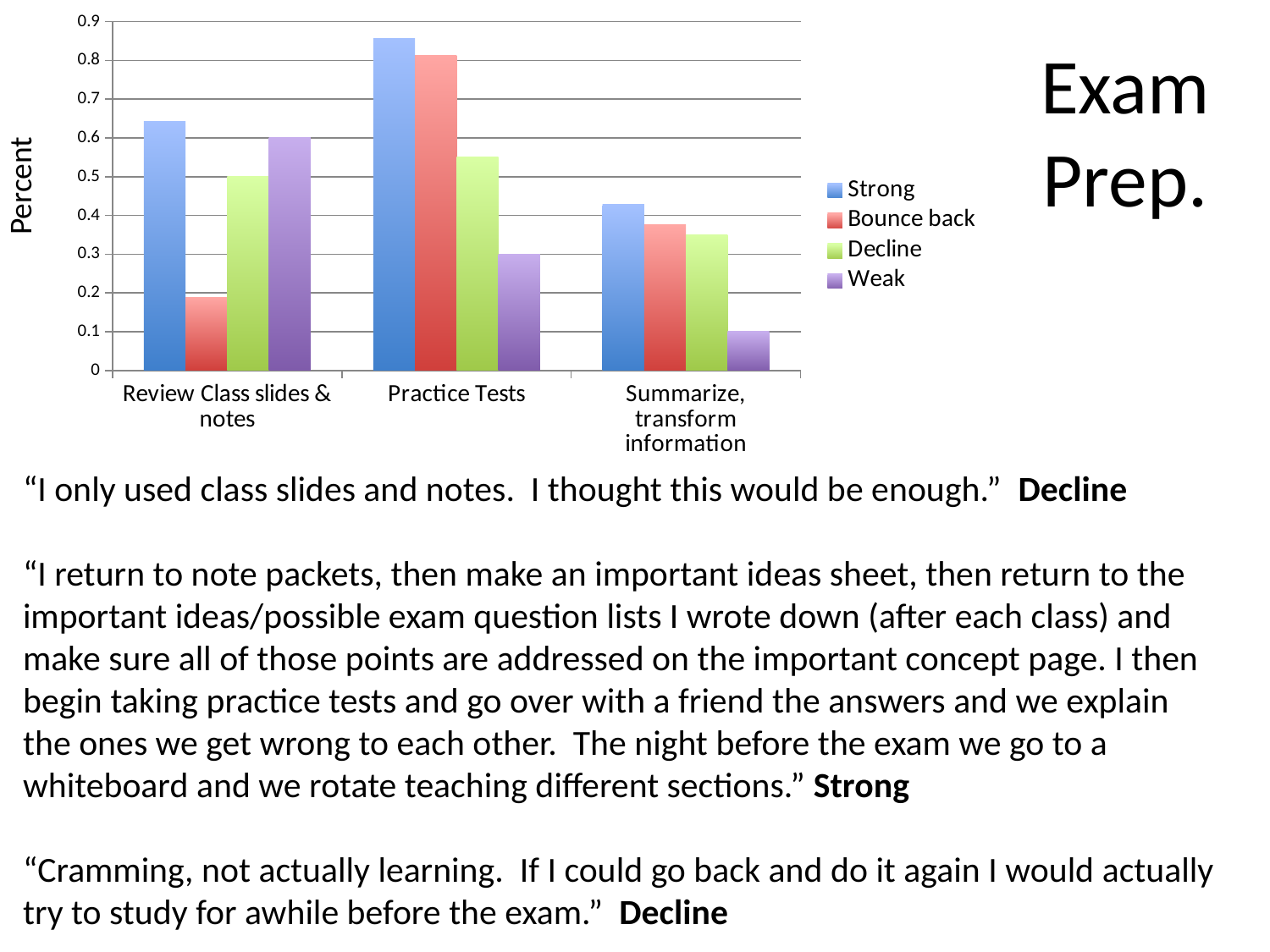
Is the Weak value for Summarize, transform information greater or less than 0.2? less How many categories are shown on the x axis? 3 Which category has the highest Strong value? Practice Tests Is the Strong value for Practice Tests greater or less than 0.8? greater How many series does the legend list? 4 What kind of chart is shown on the slide? bar chart Which category has the lowest Bounce back value? Review Class slides & notes What is the label on the y axis of the chart? Percent Which category has the lowest Weak value? Summarize, transform information For Practice Tests, which is larger: the Decline value or the Weak value? Decline Is the Bounce back value for Review Class slides & notes greater or less than 0.3? less For Review Class slides & notes, which is larger: the Strong value or the Bounce back value? Strong